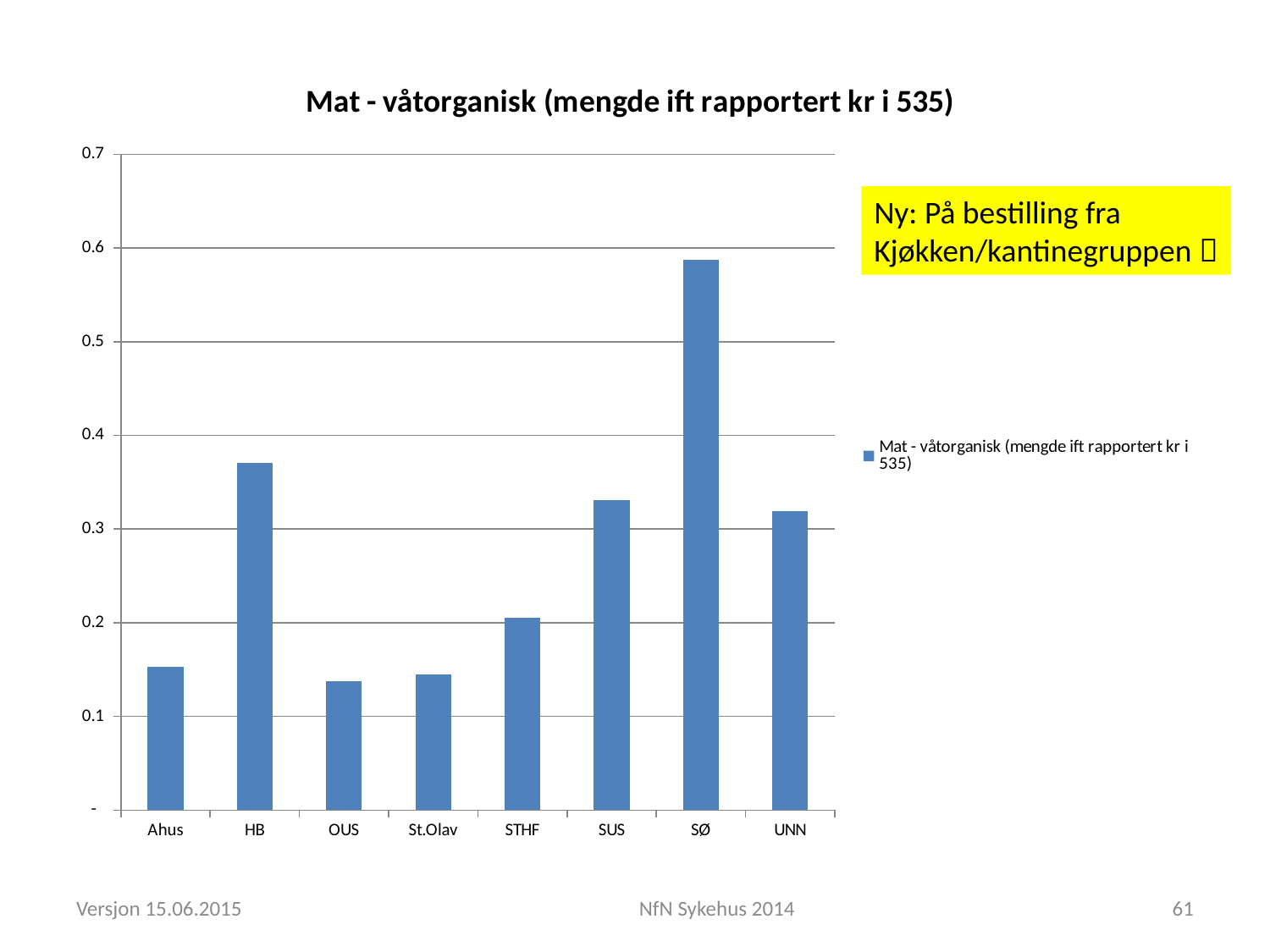
What is the title of the chart? Mat - våtorganisk (mengde ift rapportert kr i 535) How many categories are shown on the x axis of the chart? 8 What type of chart is shown on the slide? Bar chart Which has a larger value, Ahus or UNN? UNN Which has a larger value, HB or SUS? HB Is the value for SØ greater or less than 0.5? greater Which category has the highest value in the chart? SØ How many series does the legend list? 1 Is the value for Ahus greater or less than 0.2? less Is the value for HB greater or less than 0.3? greater